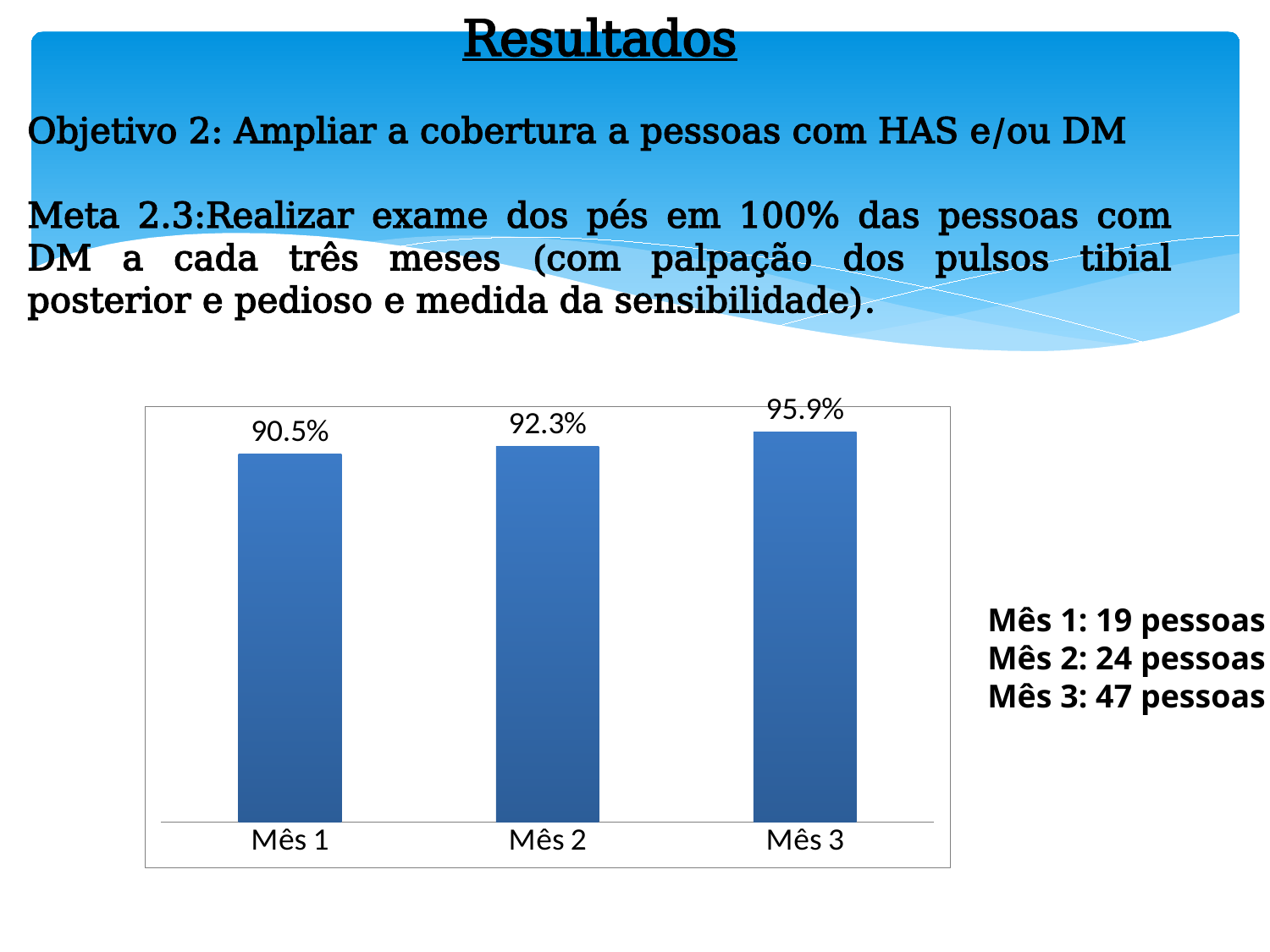
What is the value for Mês 3? 95.9% What kind of chart is shown on the slide? Bar chart How many months are shown on the chart? 3 Do the values rise or fall from Mês 1 to Mês 3? Rise Which month has the lowest value? Mês 1 Which month has the highest value? Mês 3 What colour are the bars in the chart? Blue What is the value for Mês 1? 90.5% Which is larger, the value for Mês 2 or the value for Mês 3? Mês 3 What is the value for Mês 2? 92.3% What is the difference between the values for Mês 2 and Mês 1? 1.8% What is the difference between the values for Mês 3 and Mês 1? 5.4%